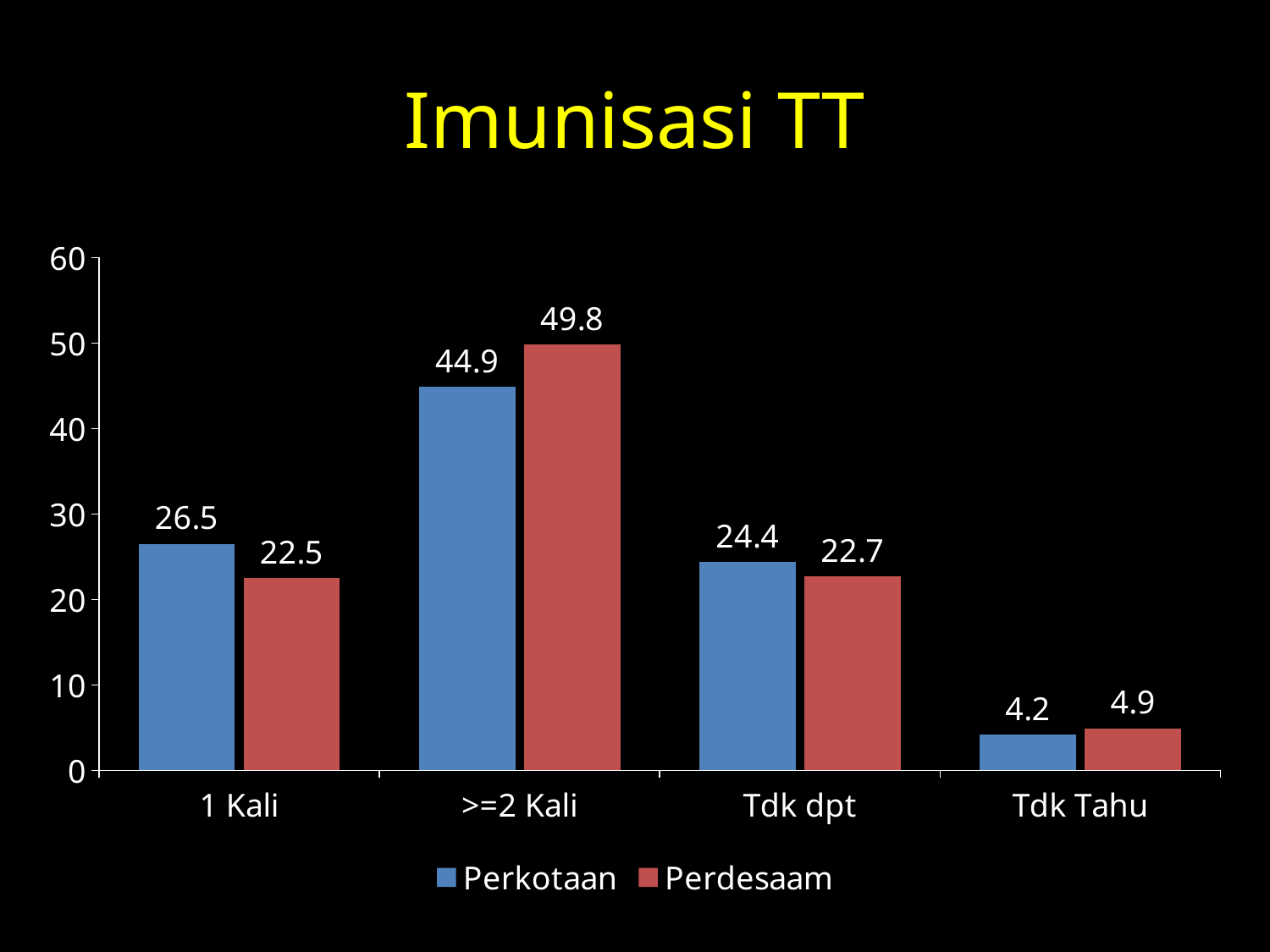
Which category has the highest Perdesaam value? >=2 Kali How many categories are shown on the x axis? 4 Which category has the lowest Perkotaan value? Tdk Tahu How many series does the legend list? 2 What is the Perdesaam value for Tdk Tahu? 4.9 What is the Perkotaan value for >=2 Kali? 44.9 What is the title of the chart? Imunisasi TT What kind of chart is shown on the slide? Bar chart What is the difference between the Perkotaan and Perdesaam values for 1 Kali? 4.0 What is the Perdesaam value for 1 Kali? 22.5 Which is larger for Tdk dpt, Perkotaan or Perdesaam? Perkotaan What is the difference between the Perdesaam and Perkotaan values for >=2 Kali? 4.9